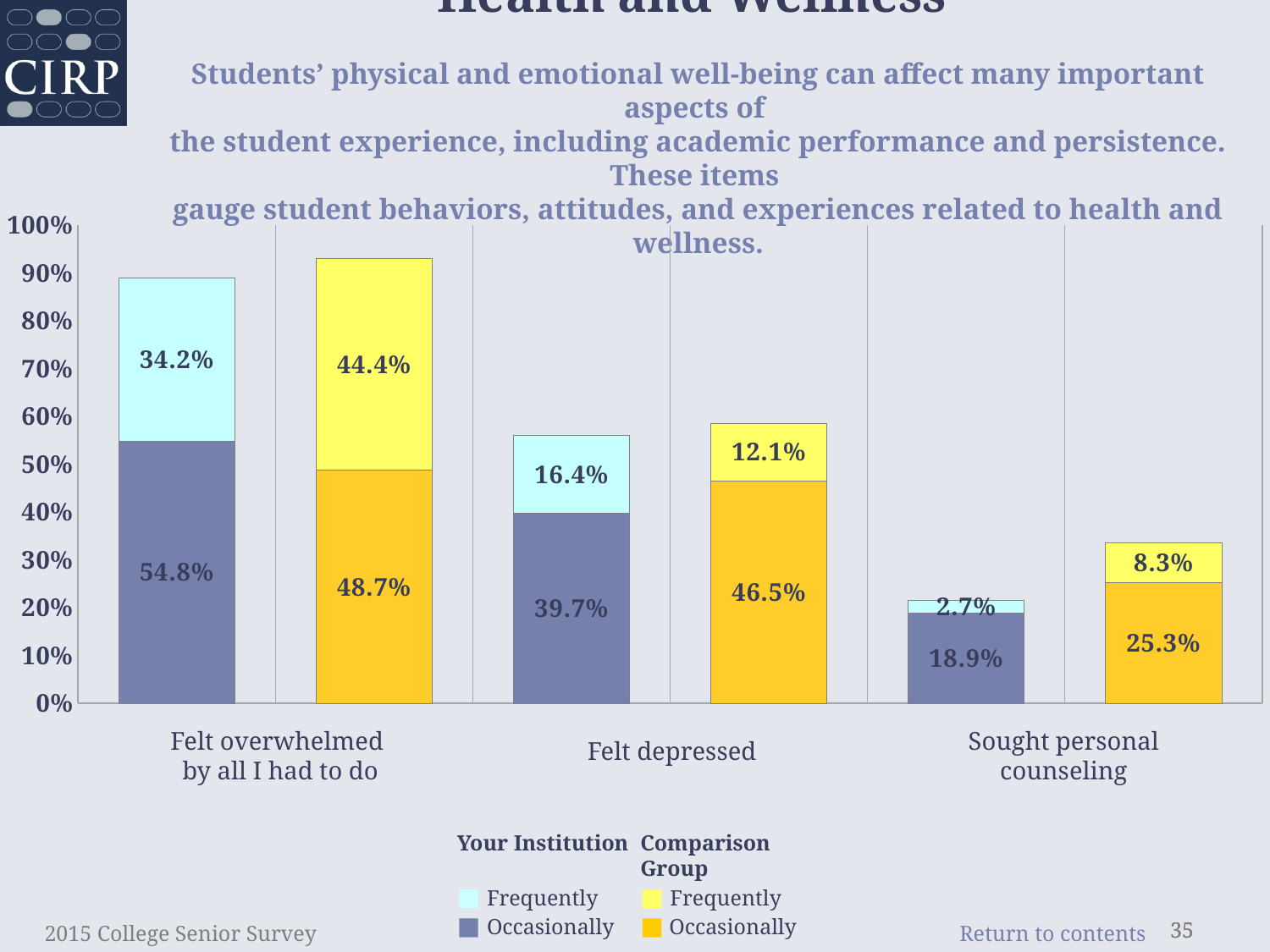
What is the difference between the Comparison Group and Your Institution 'Frequently' values for 'Felt overwhelmed by all I had to do'? 10.2% What is the total stacked value of the Comparison Group bar for 'Felt depressed'? 58.6% How many categories are shown on the x axis? 3 What is the Comparison Group 'Occasionally' value for 'Sought personal counseling'? 25.3% What is the Your Institution 'Frequently' value for 'Sought personal counseling'? 2.7% What is the Comparison Group 'Frequently' value for 'Felt depressed'? 12.1% Which is larger for 'Felt depressed': the Your Institution 'Occasionally' value or the Comparison Group 'Occasionally' value? Comparison Group (46.5%) What kind of chart is shown on the slide? Stacked bar chart What is the total stacked value of the Your Institution bar for 'Felt overwhelmed by all I had to do'? 89.0% What percentage of Your Institution students reported 'Occasionally' for 'Felt overwhelmed by all I had to do'? 54.8% How many entries does the legend list? 4 Which category has the lowest Your Institution 'Frequently' value? Sought personal counseling